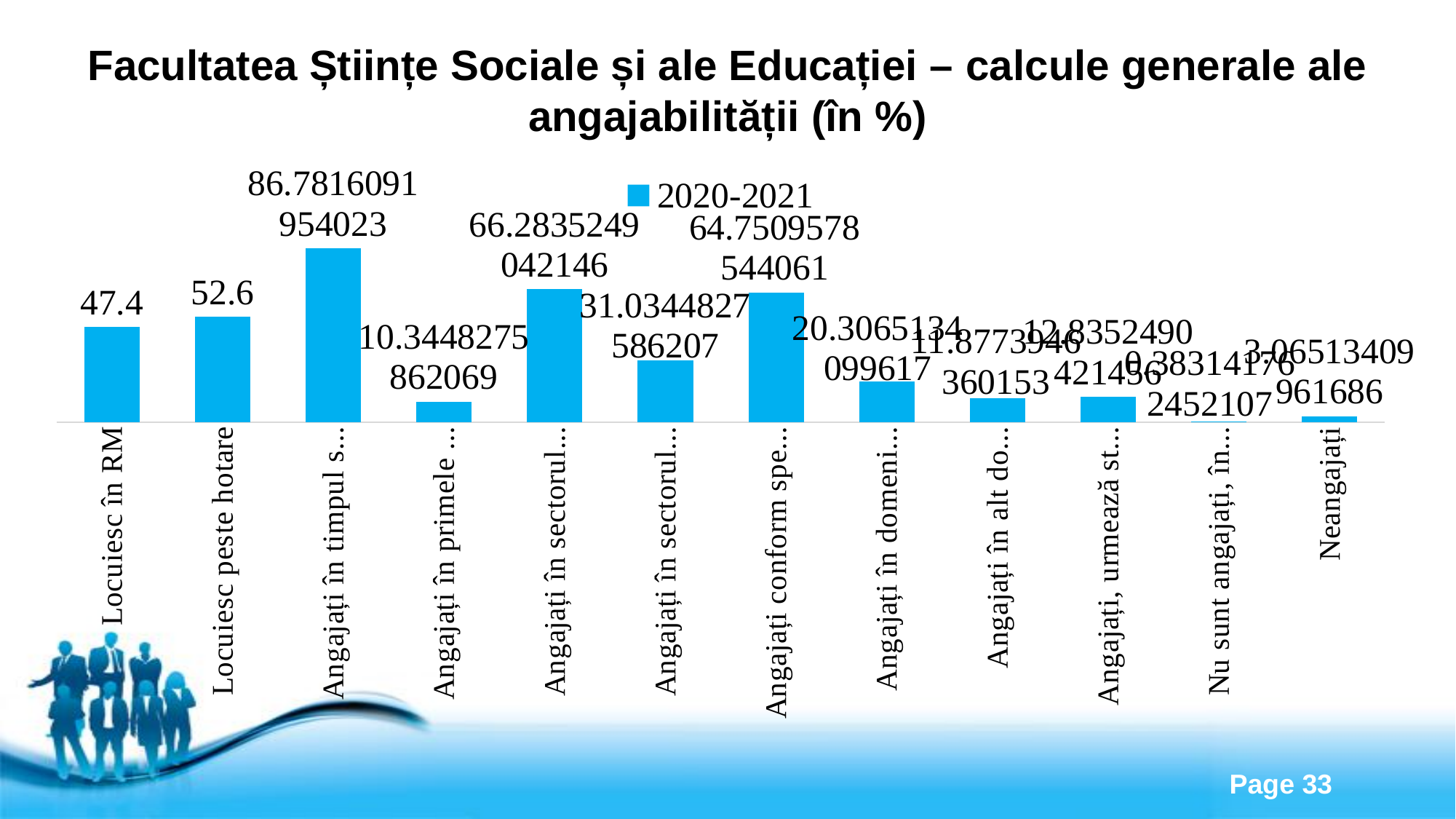
What is the title of the slide? Facultatea Științe Sociale și ale Educației – calcule generale ale angajabilității (în %) What is the value for "Locuiesc în RM"? 47.4 What kind of chart is shown on the slide? Bar chart What is the value for "Neangajați"? 3.06513409961686 What is the value for "Locuiesc peste hotare"? 52.6 What is the highest value shown in the chart? 86.7816091954023 What series name is shown in the legend? 2020-2021 Which is larger, the value for "Locuiesc în RM" or for "Neangajați"? Locuiesc în RM How many series does the legend list? 1 How many categories are shown in the chart? 12 Which is larger, the value for "Locuiesc în RM" or for "Locuiesc peste hotare"? Locuiesc peste hotare What is the difference between the values for "Locuiesc peste hotare" and "Locuiesc în RM"? 5.2